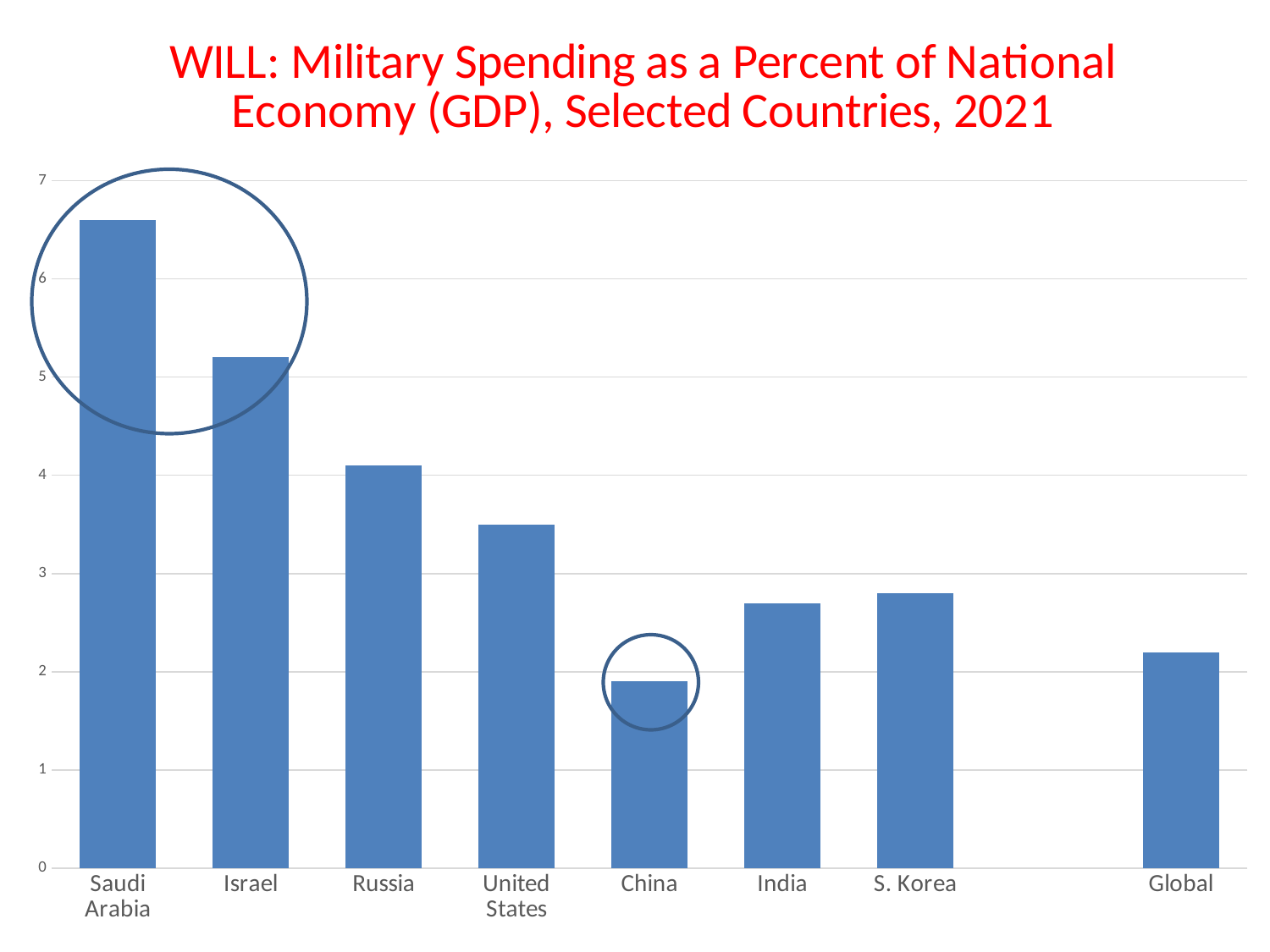
Is the value for Global greater or less than 2? greater What kind of chart is shown on the slide? Bar chart Which is larger, the value for Russia or the value for the United States? Russia Is the value for Israel greater or less than 5? greater Which country has the highest military spending as a percent of GDP? Saudi Arabia Is the value for Russia greater or less than 4? greater How many categories (bars) are shown in the chart? 8 Which category has the lowest bar in the chart? China Which two bars are enclosed by the large circle on the chart? Saudi Arabia and Israel